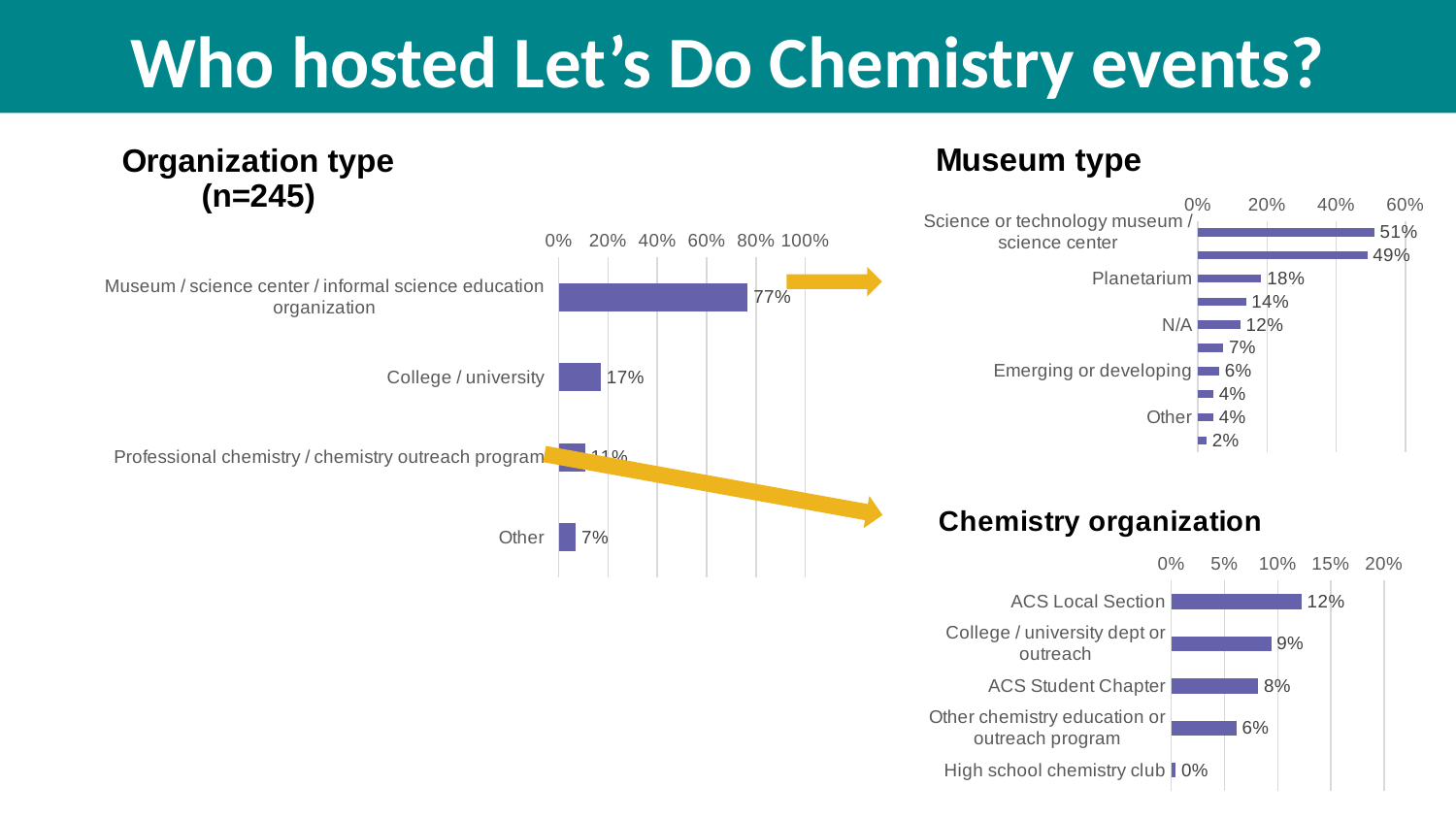
In the Chemistry organization chart, how many categories are shown? 5 In the Museum type chart, what percentage is shown for Emerging or developing? 6% In the Chemistry organization chart, which category has the lowest value? High school chemistry club In the Organization type chart, what is the difference between the Museum / science center / informal science education organization value and the Other value? 70% In the Chemistry organization chart, what percentage is shown for ACS Local Section? 12% In the Chemistry organization chart, what is the difference between the ACS Local Section value and the ACS Student Chapter value? 4% In the Museum type chart, what percentage is shown for Planetarium? 18% In the Organization type chart, which category has the highest value? Museum / science center / informal science education organization In the Organization type chart, what percentage is shown for College / university? 17% In the Organization type chart, what kind of chart is used? Bar chart In the Museum type chart, is the value for Science or technology museum / science center greater or less than 40%? greater In the Museum type chart, which is larger: the value for N/A or the value for Other? N/A